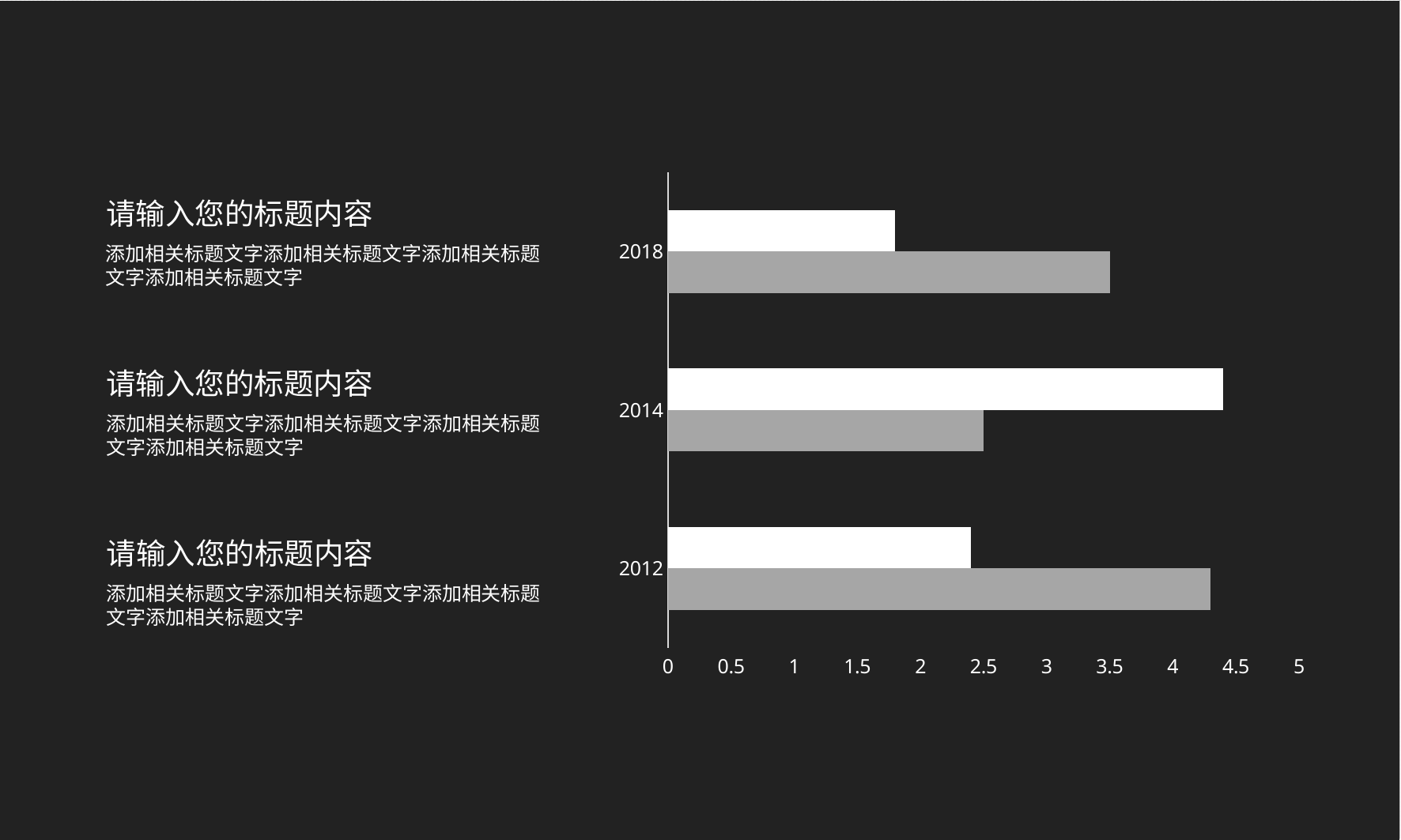
Is the value of the white bar for 2018 greater or less than 2? less Is the value of the white bar for 2014 greater or less than 4? greater Is the value of the gray bar for 2012 greater or less than 4? greater How many categories (years) are shown on the chart? 3 Which year has the longest white bar? 2014 What is the difference between the gray bar for 2018 and the gray bar for 2014? 1 For 2018, which bar is longer, the white bar or the gray bar? the gray bar What kind of chart is shown on the slide? bar chart What is the value of the gray bar for 2014? 2.5 What is the value of the gray bar for 2018? 3.5 Which year has the shortest gray bar? 2014